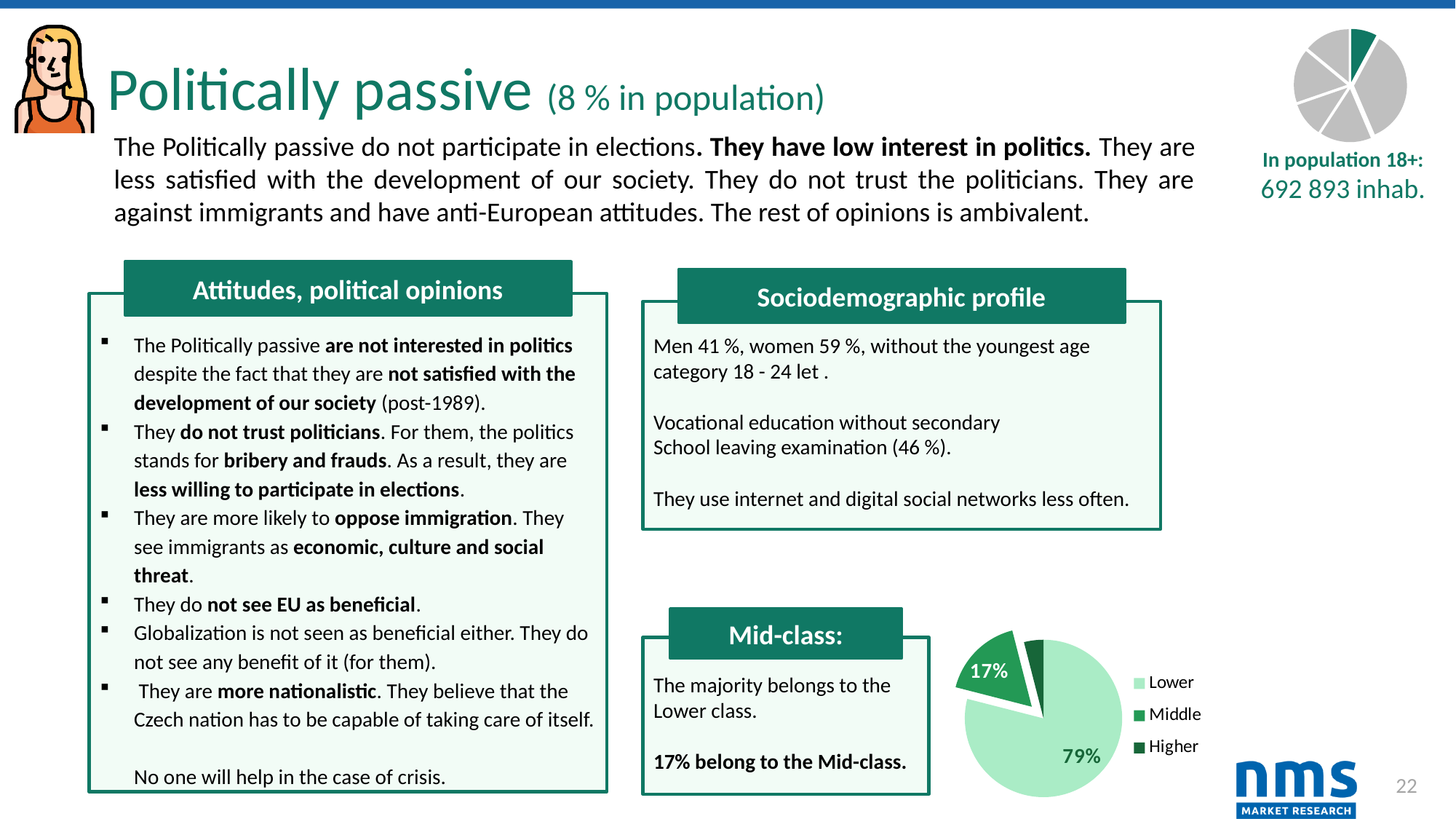
In the pie chart at the bottom right of the slide, which slice has no percentage label printed on it? Higher In the pie chart at the bottom right of the slide, which slice is larger, Middle or Higher? Middle How many categories does the legend of the pie chart at the bottom right of the slide list? 3 In the pie chart at the bottom right of the slide, which class has the largest slice? Lower In the pie chart at the bottom right of the slide, what is the difference in percentage points between the Lower and Middle slices? 62 percentage points In the pie chart at the bottom right of the slide, what share belongs to the Lower class? 79% What are the legend entries of the pie chart at the bottom right of the slide, from top to bottom? Lower, Middle, Higher What kind of chart is shown at the bottom right of the slide next to the Mid-class box? Pie chart In the pie chart at the bottom right of the slide, what share belongs to the Middle class? 17% In the pie chart at the bottom right of the slide, which slice is larger, Lower or Middle? Lower In the pie chart at the bottom right of the slide, which class has the smallest slice? Higher